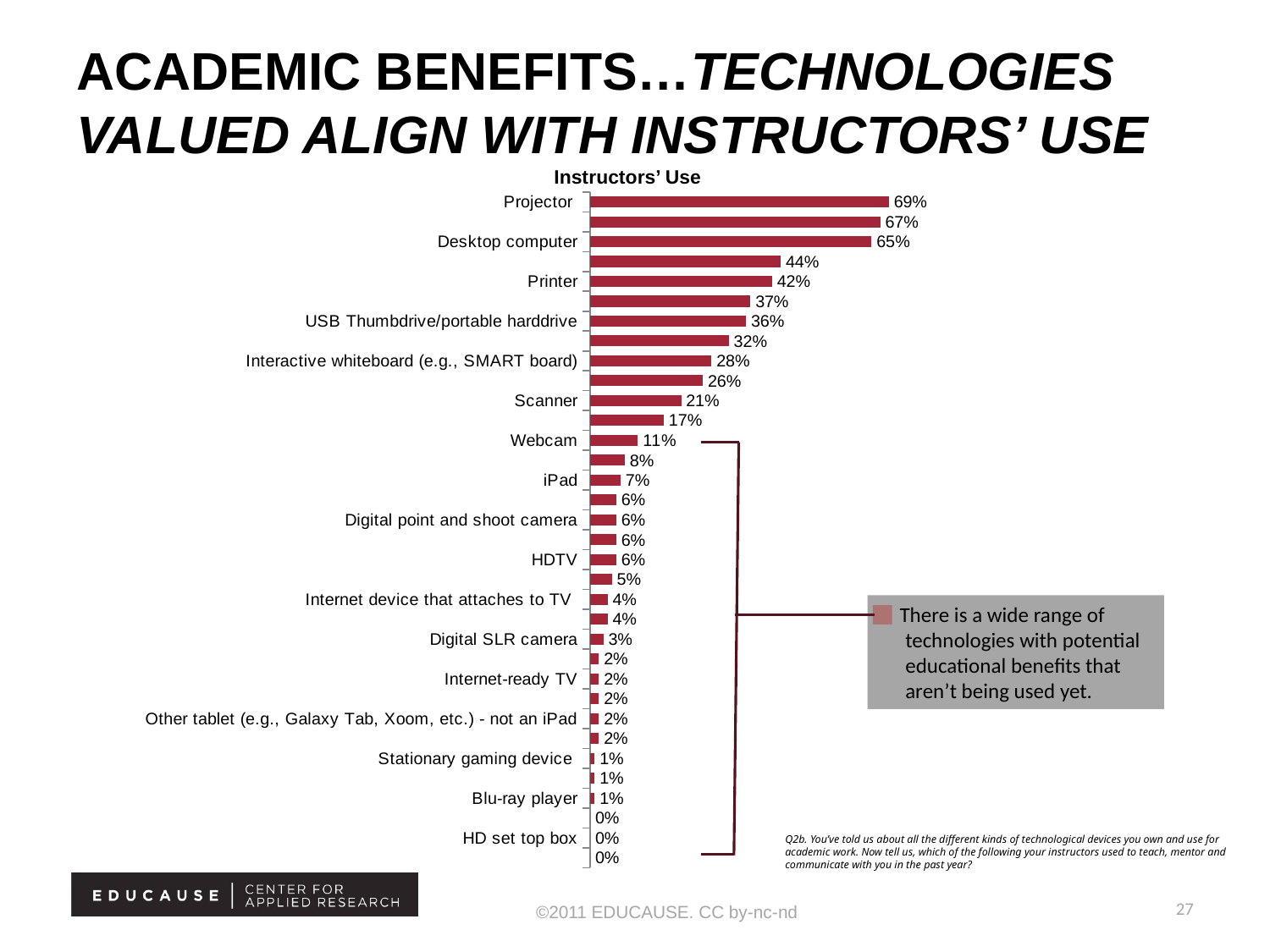
What is the value for Interactive whiteboard (e.g., SMART board)? 28% What kind of chart is shown on the slide? bar chart What is the value for Webcam? 11% Which category has the highest value? Projector Which is larger, the value for Printer or the value for Scanner? Printer What is the difference between the values for USB Thumbdrive/portable harddrive and iPad? 29% What is the value for Desktop computer? 65% What is the value for HD set top box? 0% Do the bar values increase or decrease going from the top of the chart to the bottom? decrease What is the value for Projector? 69% What is the title of the chart? Instructors' Use What is the difference between the values for Projector and Desktop computer? 4%